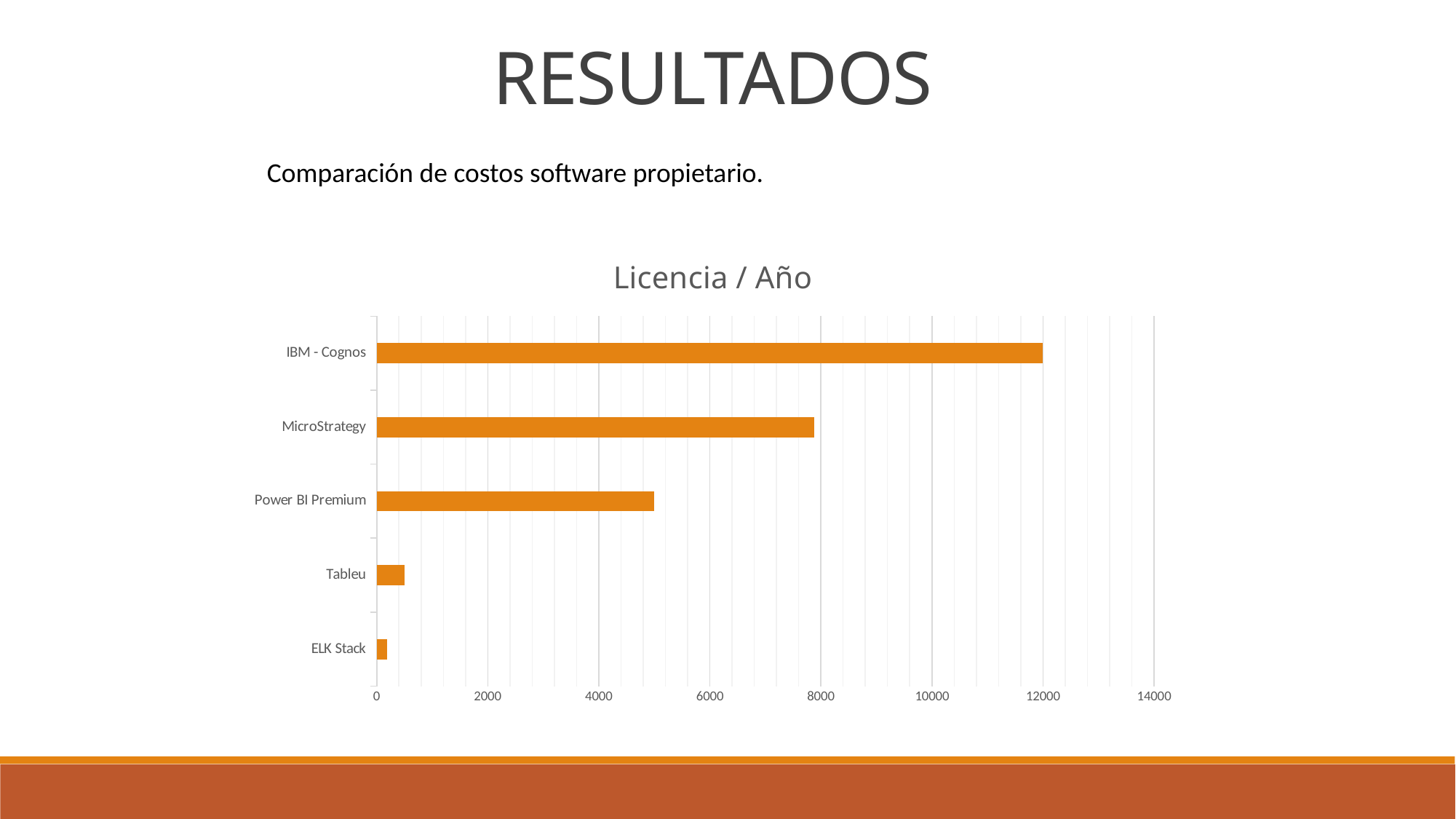
Is the value for MicroStrategy greater or less than 8000? less Which category has the lowest value in the "Licencia / Año" chart? ELK Stack Which is larger, the value for MicroStrategy or the value for Power BI Premium? MicroStrategy How many categories are plotted in the "Licencia / Año" chart? 5 Is the value for Tableu greater or less than 2000? less What is the title of the chart on the slide? Licencia / Año Is the value for MicroStrategy greater or less than 6000? greater Which is larger, the value for Tableu or the value for ELK Stack? Tableu What kind of chart is shown under the title "Licencia / Año"? bar chart What is the value for IBM - Cognos in the "Licencia / Año" chart? 12000 Which category has the highest value in the "Licencia / Año" chart? IBM - Cognos